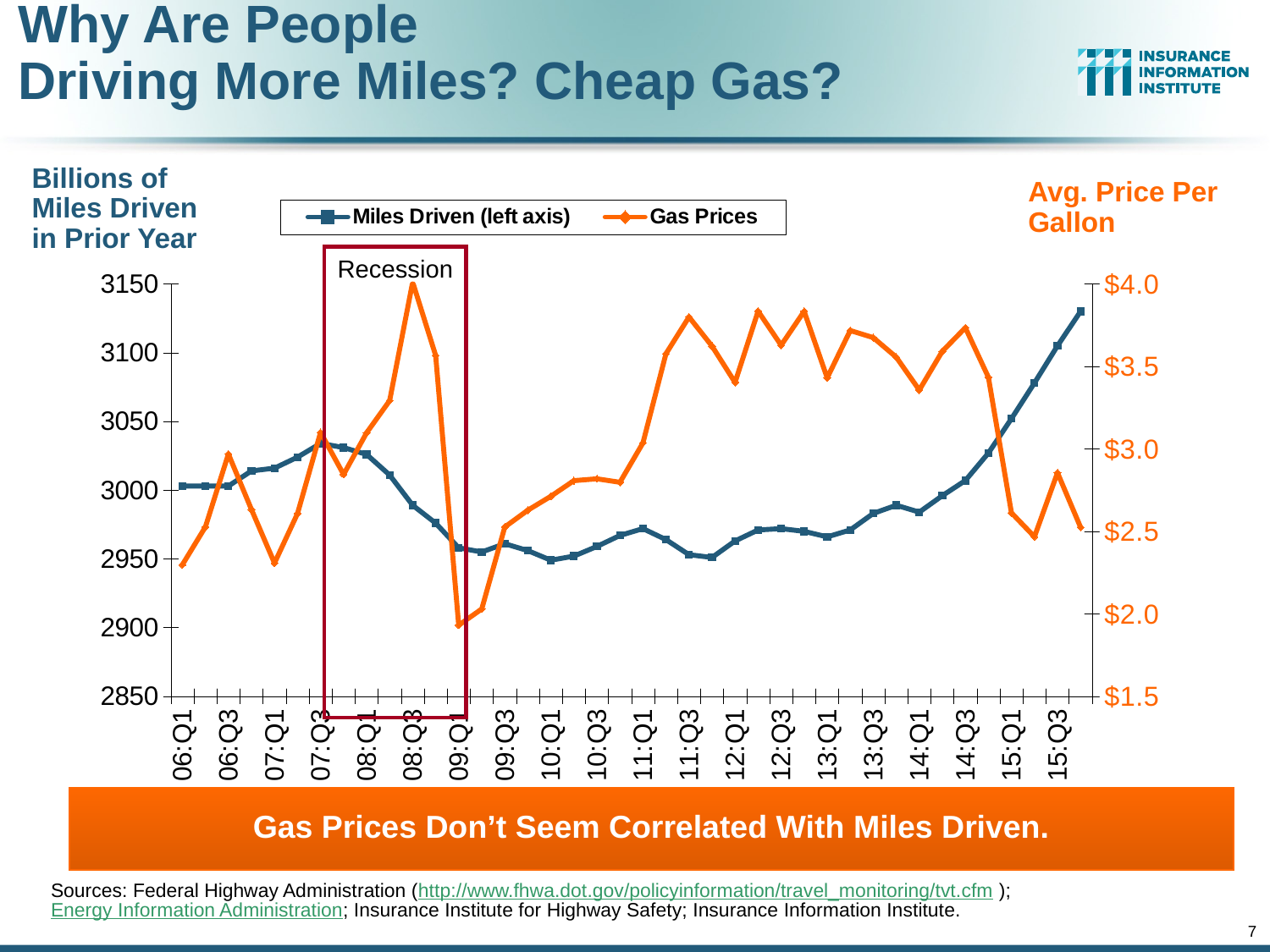
Is the Miles Driven value at 15:Q3 greater or less than 3050? greater Does the Miles Driven line rise or fall from 14:Q1 to the end of the series? rise Is the Gas Prices value at 12:Q3 greater or less than $3.5? greater Is the Miles Driven value at 09:Q3 greater or less than 3000? less Which is higher, the Gas Prices value at 11:Q3 or at 09:Q1? 11:Q3 In which year does the Gas Prices line reach its highest point? 2008 What kind of chart is shown on the slide? Line chart How many series does the legend list? 2 What label is shown on the boxed region of the chart covering late 2007 to early 2009? Recession What are the two series named in the legend? Miles Driven (left axis) and Gas Prices